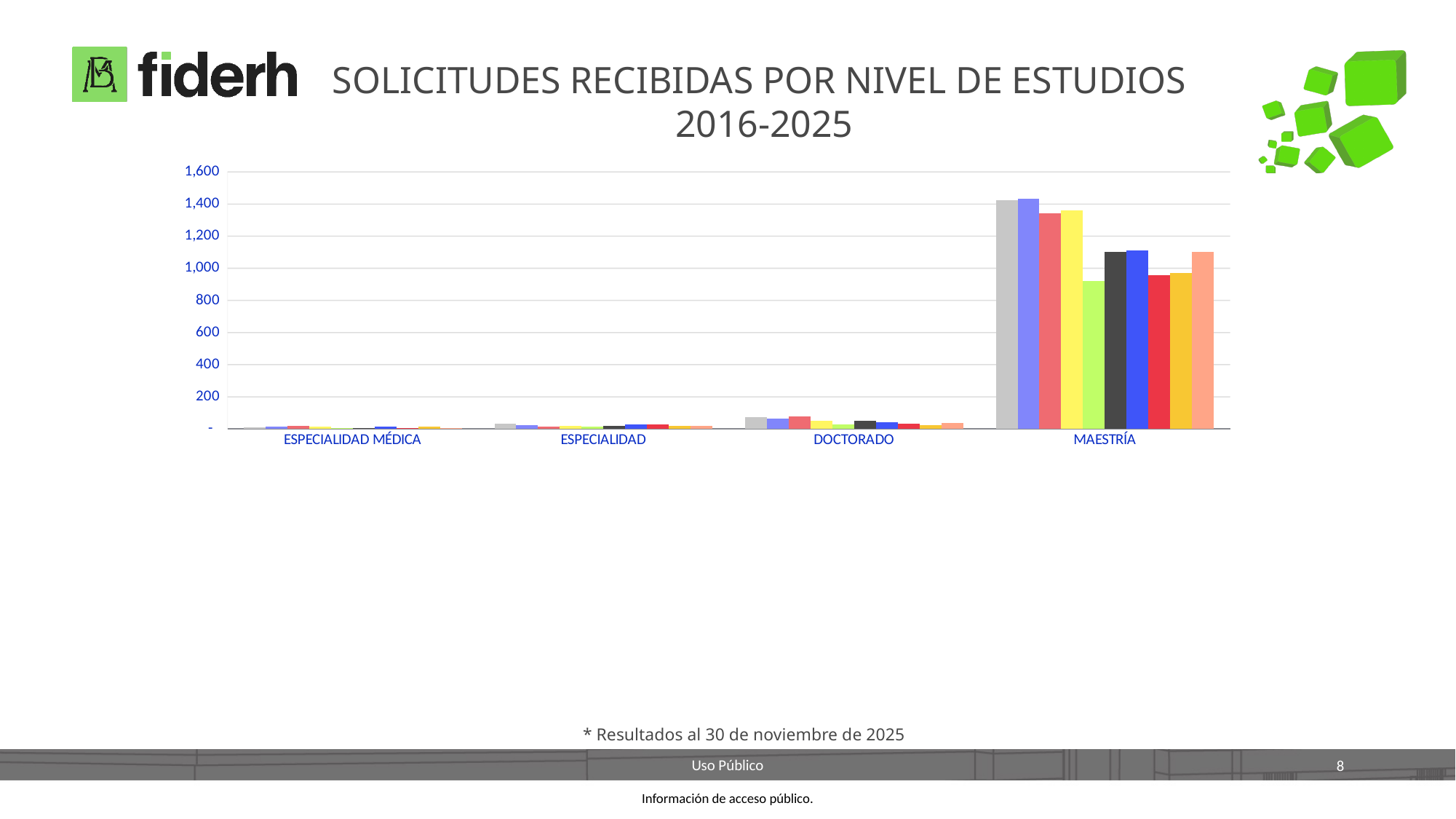
Is the light green bar for MAESTRÍA greater or less than 1,000? less What is the title of the chart? SOLICITUDES RECIBIDAS POR NIVEL DE ESTUDIOS 2016-2025 Are the values for DOCTORADO greater or less than 200? less What kind of chart is shown on the slide? bar chart Is the first (grey) bar for MAESTRÍA greater or less than 1,200? greater Which category has the highest bars? MAESTRÍA What is the highest value shown on the y axis? 1,600 Which category has the lowest bars? ESPECIALIDAD MÉDICA Which category has larger values, DOCTORADO or MAESTRÍA? MAESTRÍA How many study-level categories are shown on the x axis? 4 How many bars are plotted for each category? 10